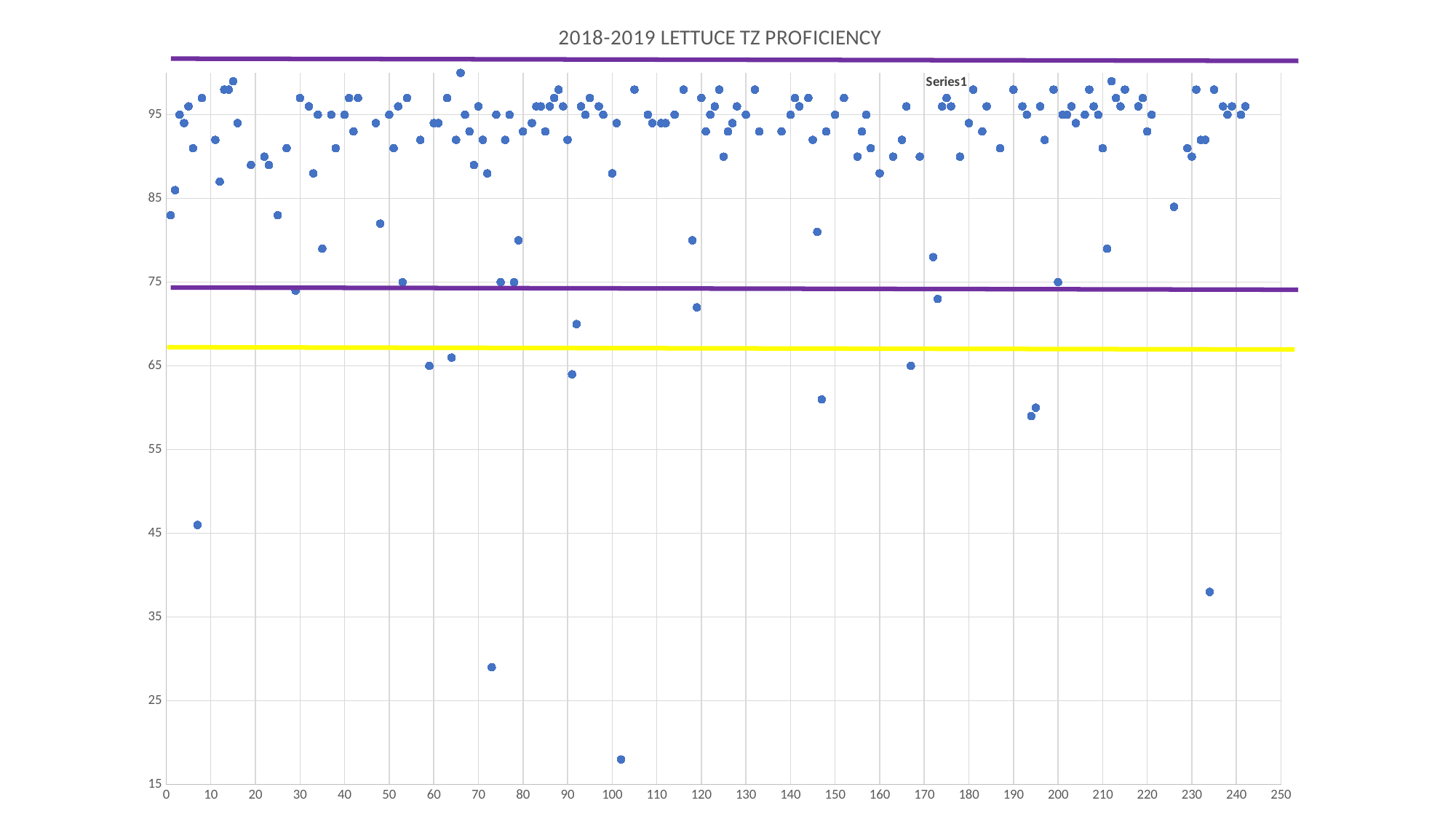
Is the value of the point plotted near x = 234 greater or less than 45? less Is the value of the point plotted near x = 7 greater or less than 55? less Is the value of the lowest point on the chart greater or less than 25? less What kind of chart is shown on the slide? scatter chart What is the title of the chart? 2018-2019 LETTUCE TZ PROFICIENCY What is the highest value labelled on the x axis? 250